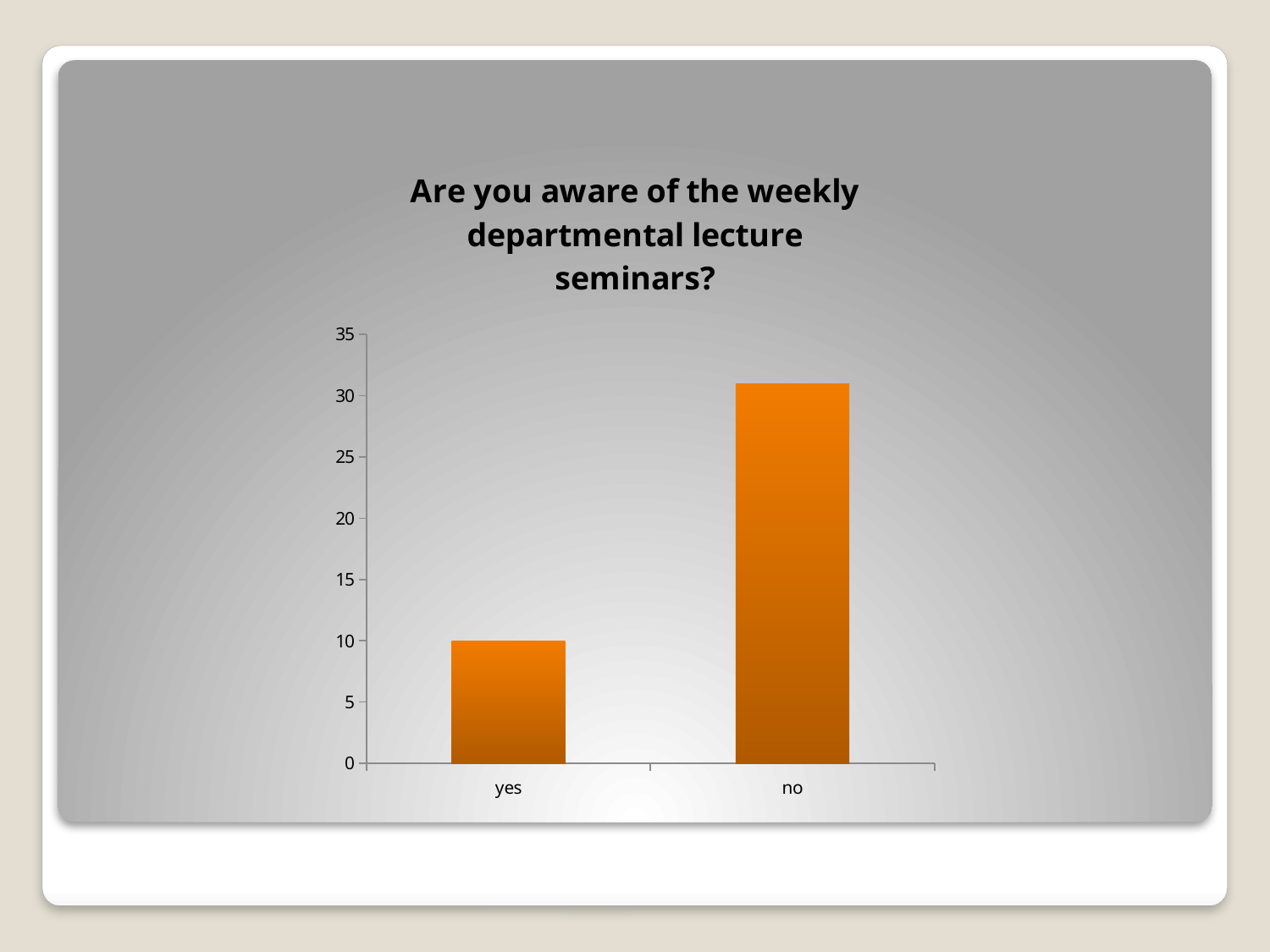
Which category has the lowest value in the chart? yes Which is larger, the value for "yes" or the value for "no"? no What is the value for "yes" in the chart? 10 Do the values rise or fall moving from "yes" to "no" along the x axis? rise Is the value for "yes" greater or less than 15? less What is the highest value shown on the chart's vertical axis? 35 How many categories are shown on the x axis of the chart? 2 Is the value for "no" greater or less than 25? greater What is the title of the chart? Are you aware of the weekly departmental lecture seminars? Which category has the highest value in the chart? no What kind of chart is shown on the slide? bar chart